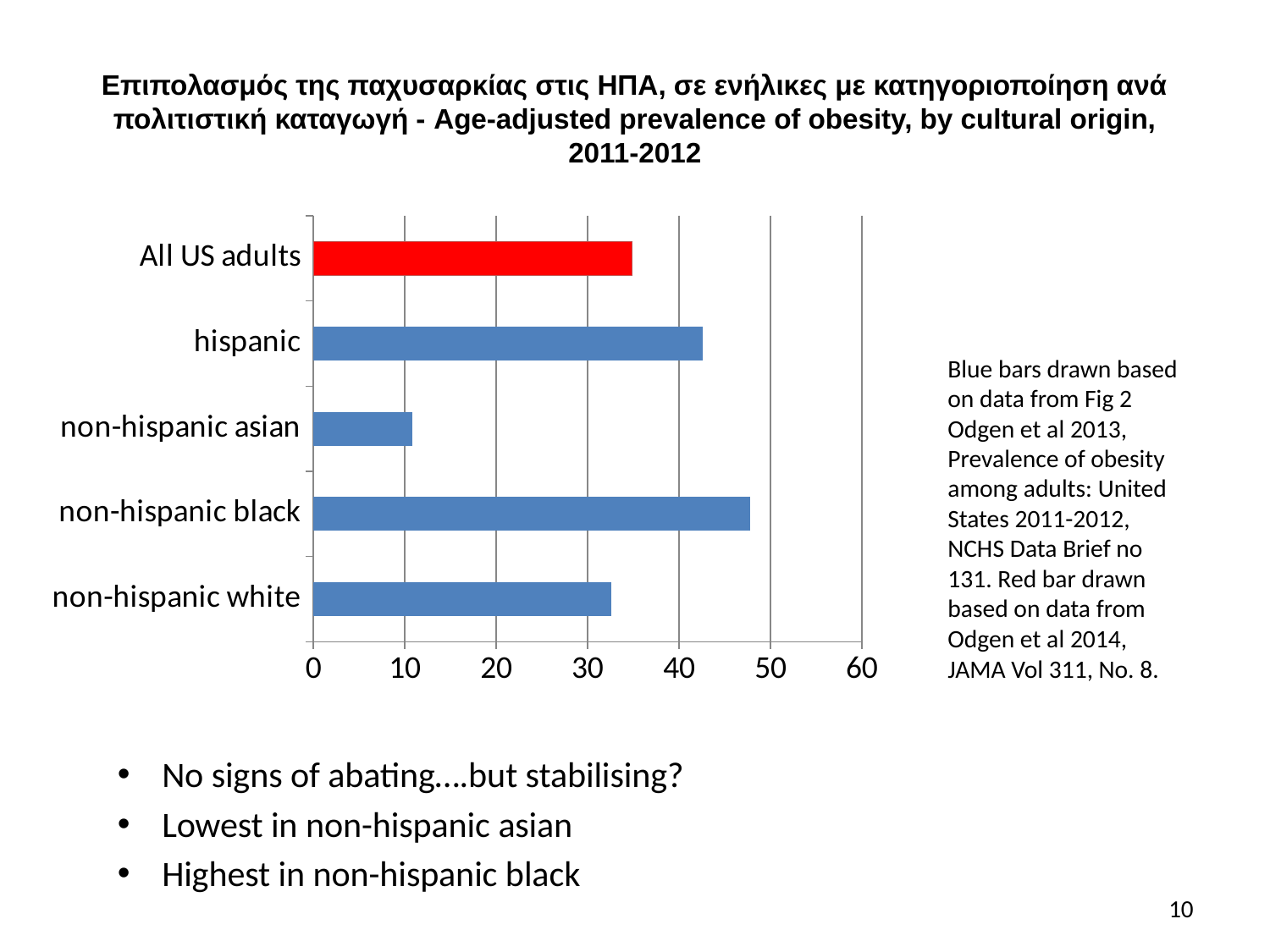
Is the value for non-hispanic asian greater or less than 20? less Is the value for non-hispanic black greater or less than 40? greater Which category has the highest value in the chart? non-hispanic black Which bar in the chart is coloured red? All US adults What kind of chart is shown on the slide? bar chart Is the value for non-hispanic white greater or less than 40? less Which is larger, the value for hispanic or the value for non-hispanic white? hispanic Which is larger, the value for All US adults or the value for non-hispanic asian? All US adults Which category has the lowest value in the chart? non-hispanic asian How many categories are plotted in the chart? 5